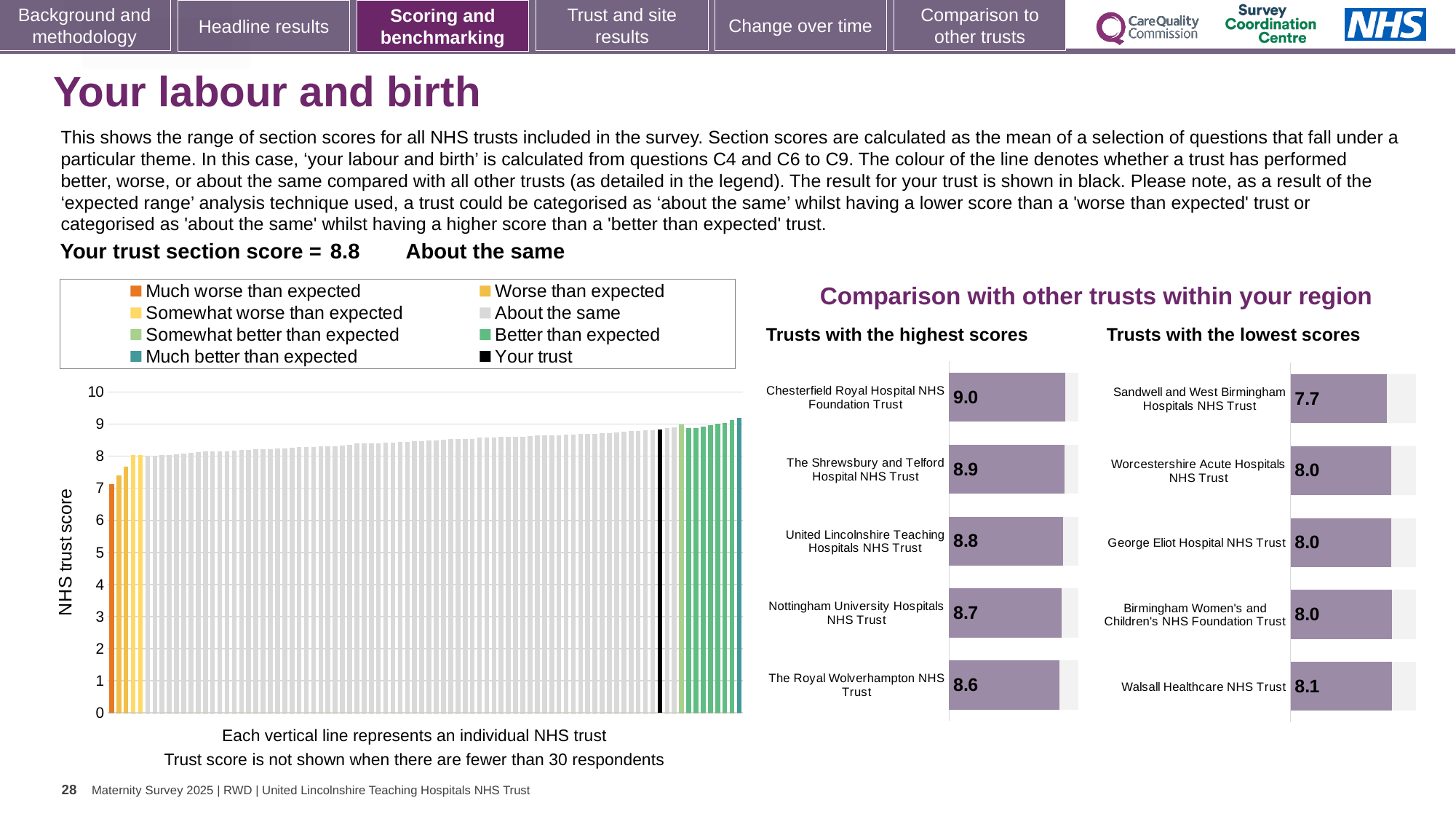
How many entries does the legend of the 'NHS trust score' chart on the left list? 8 In the 'Trusts with the lowest scores' chart, what is the score for Walsall Healthcare NHS Trust? 8.1 What kind of chart is the 'NHS trust score' chart on the left of the slide? Bar chart How many trusts are shown in the 'Trusts with the highest scores' chart? 5 In the 'Trusts with the highest scores' chart, what is the score for The Royal Wolverhampton NHS Trust? 8.6 In the 'NHS trust score' chart on the left, is the value of the black bar (your trust) greater or less than 8? greater In the 'Trusts with the highest scores' chart, which trust has the highest score? Chesterfield Royal Hospital NHS Foundation Trust In the 'Trusts with the lowest scores' chart, which is larger: the score for Walsall Healthcare NHS Trust or the score for Sandwell and West Birmingham Hospitals NHS Trust? Walsall Healthcare NHS Trust In the 'Trusts with the highest scores' chart, what is the difference between the scores of Chesterfield Royal Hospital NHS Foundation Trust and The Royal Wolverhampton NHS Trust? 0.4 In the 'NHS trust score' chart on the left, do the bar heights rise or fall from left to right? Rise In the 'Trusts with the highest scores' chart, what is the score for Chesterfield Royal Hospital NHS Foundation Trust? 9.0 In the 'Trusts with the lowest scores' chart, which trust has the lowest score? Sandwell and West Birmingham Hospitals NHS Trust